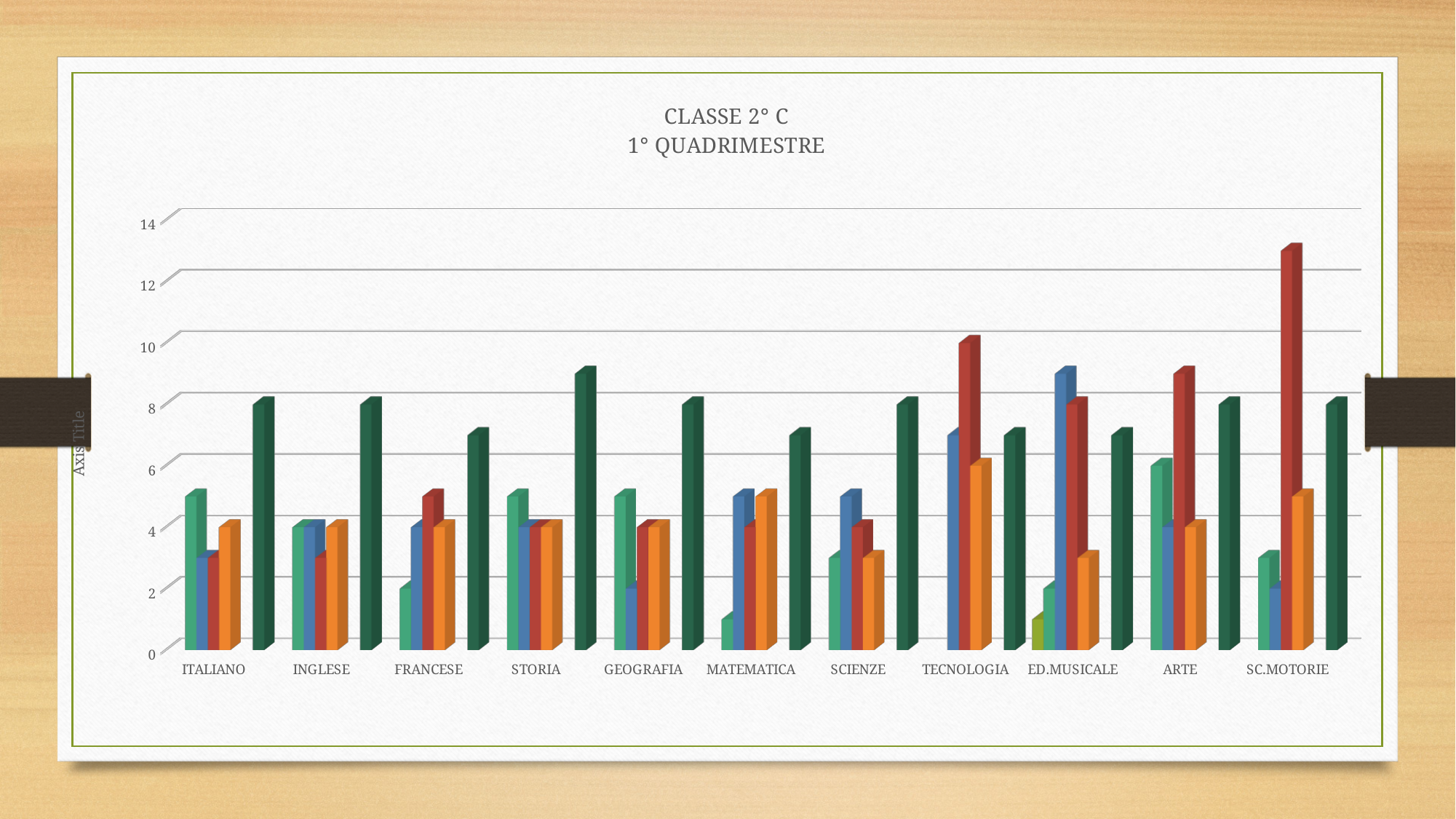
Is the value of the orange bar for TECNOLOGIA greater or less than 4? greater What text is shown as the vertical axis title? Axis Title Is the value of the dark green bar for STORIA greater or less than 8? greater How many subject categories are shown on the x axis? 11 Is the value of the blue bar for ED.MUSICALE greater or less than 8? greater What kind of chart is shown on the slide? bar chart Which category contains the tallest bar in the chart? SC.MOTORIE What is the title of the chart? CLASSE 2° C 1° QUADRIMESTRE For FRANCESE, which is taller: the light green bar or the red bar? the red bar